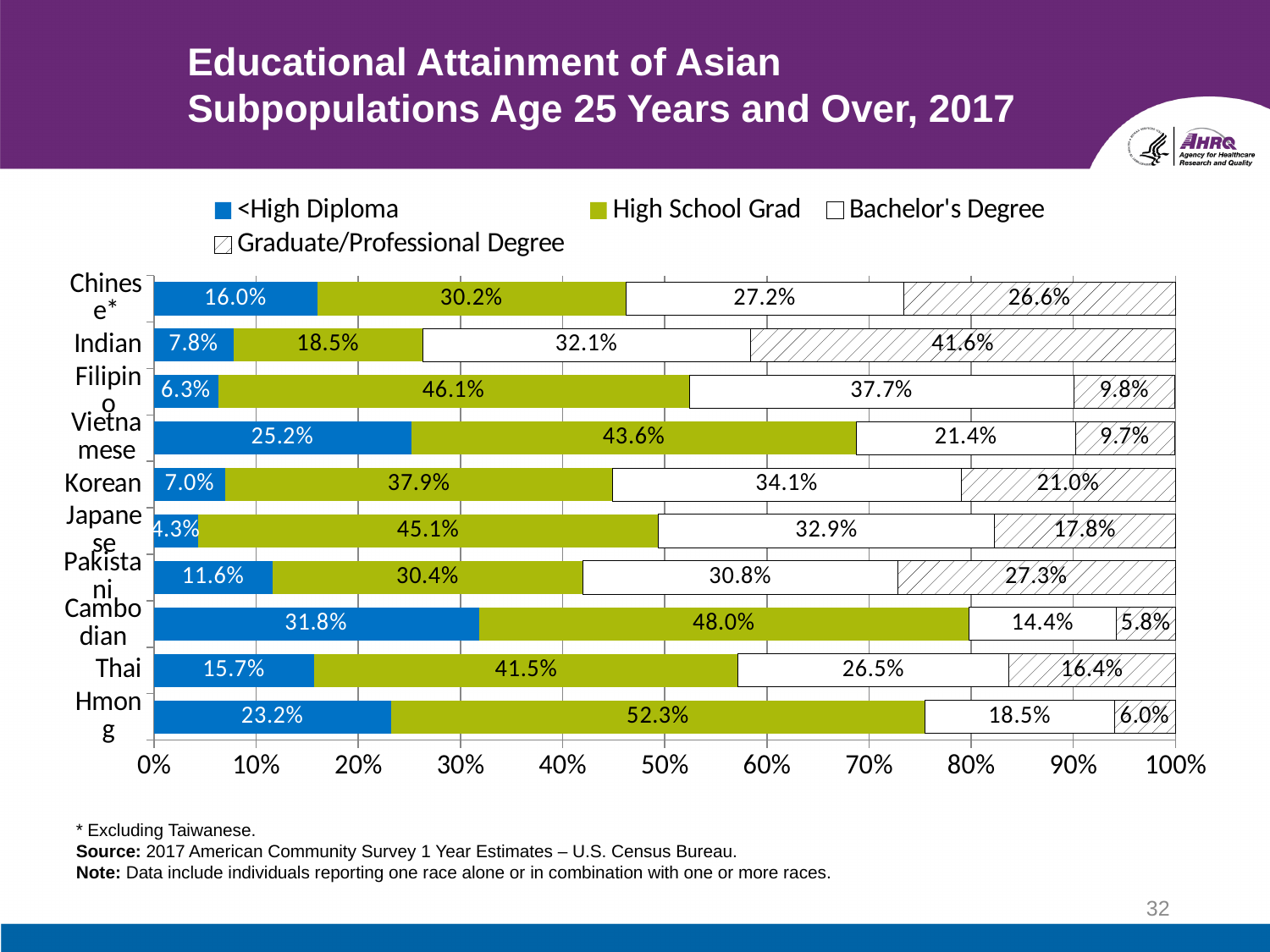
Which subpopulation has the lowest <High Diploma share? Japanese What is the Bachelor's Degree value for Filipino? 37.7% What percentage of Indians age 25 and over have a Graduate/Professional Degree? 41.6% Which subpopulation has the highest <High Diploma share? Cambodian How many series does the legend list? 4 What type of chart is shown on the slide? Stacked bar chart What is the difference between the Bachelor's Degree values for Indian and Chinese*? 4.9 percentage points Which subpopulation has the highest Graduate/Professional Degree share? Indian Which legend entry is shown with a hatched pattern? Graduate/Professional Degree What is the High School Grad value for Hmong? 52.3% How many Asian subpopulations are shown on the chart? 10 Which is larger, the High School Grad value for Vietnamese or for Korean? Vietnamese